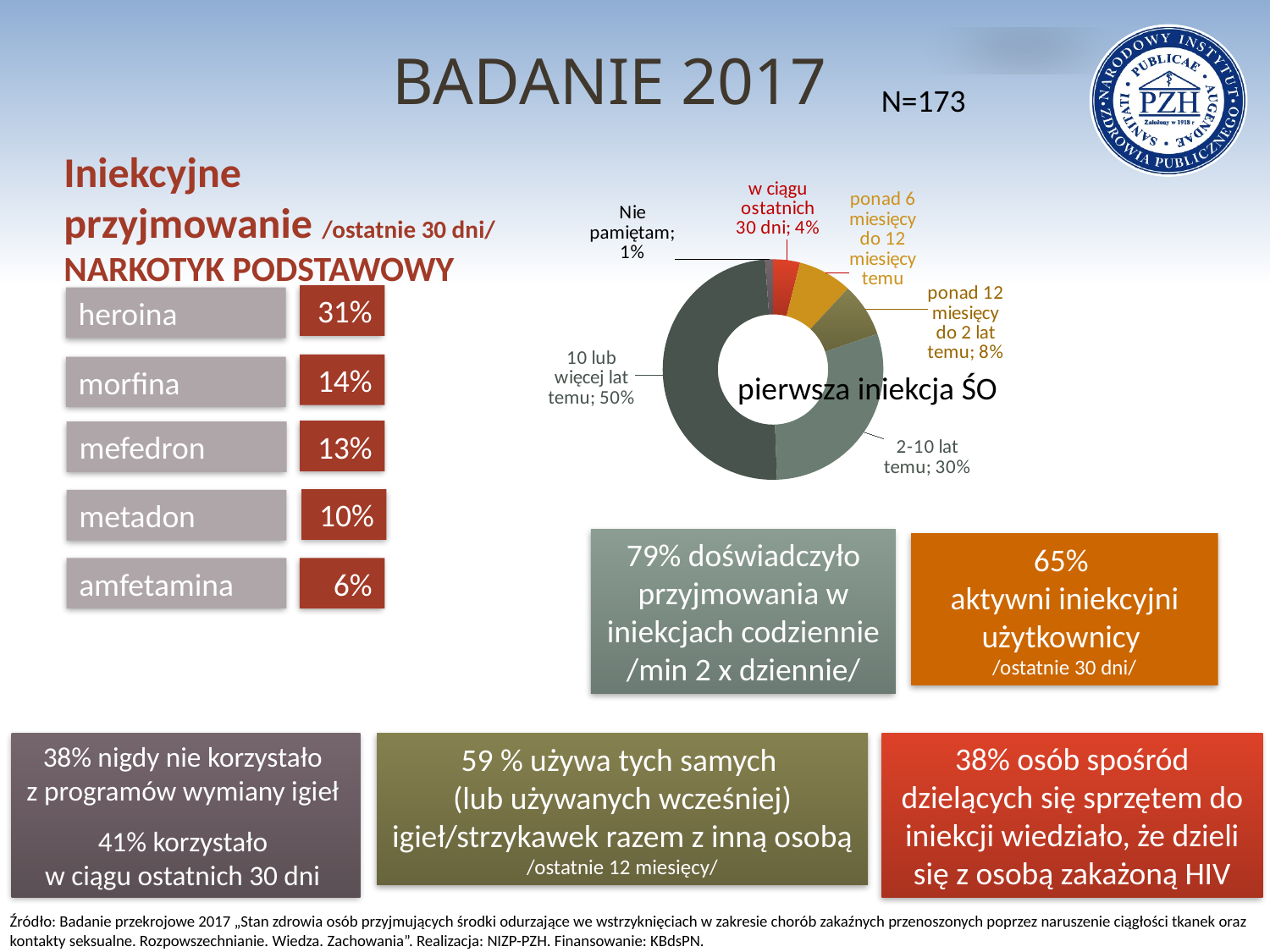
In the donut chart 'pierwsza iniekcja ŚO', what share is shown for '10 lub więcej lat temu'? 50% In the donut chart 'pierwsza iniekcja ŚO', what share is shown for 'w ciągu ostatnich 30 dni'? 4% In the donut chart 'pierwsza iniekcja ŚO', what share is shown for 'ponad 12 miesięcy do 2 lat temu'? 8% How many slices does the donut chart 'pierwsza iniekcja ŚO' have? 6 In the donut chart 'pierwsza iniekcja ŚO', what share is shown for '2-10 lat temu'? 30% What is the title written in the centre of the donut chart? pierwsza iniekcja ŚO In the donut chart 'pierwsza iniekcja ŚO', what share is shown for 'Nie pamiętam'? 1% In the donut chart 'pierwsza iniekcja ŚO', which is larger: '2-10 lat temu' or 'ponad 12 miesięcy do 2 lat temu'? 2-10 lat temu In the donut chart 'pierwsza iniekcja ŚO', which labelled category has the smallest share? Nie pamiętam In the donut chart 'pierwsza iniekcja ŚO', how many percentage points larger is '10 lub więcej lat temu' than '2-10 lat temu'? 20 percentage points In the donut chart 'pierwsza iniekcja ŚO', which category has the largest share? 10 lub więcej lat temu What kind of chart is used to show 'pierwsza iniekcja ŚO'? Donut (pie) chart